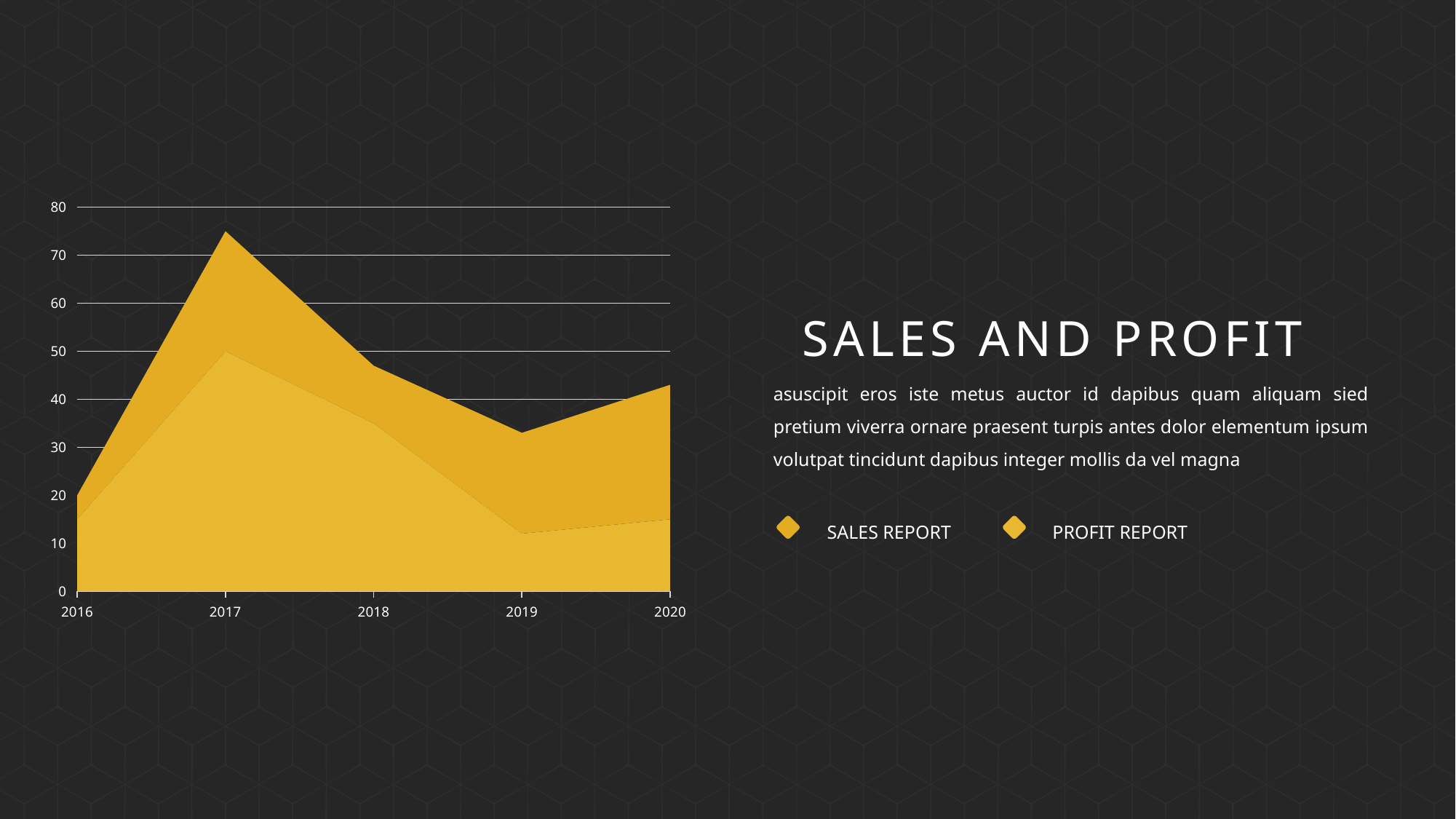
Do the values of the upper (darker) area rise or fall from 2017 to 2019? fall What kind of chart is shown on the slide? Area chart Is the value of the upper (darker) area in 2016 greater or less than 30? less Which year has the larger value for the upper (darker) area, 2017 or 2019? 2017 What are the two legend entries shown on the slide? Sales Report and Profit Report Is the value of the upper (darker) area in 2019 greater or less than 40? less Is the value of the lower (lighter) area in 2019 greater or less than 20? less How many series does the legend list? 2 In which year does the upper (darker) area reach its highest point? 2017 In which year is the upper (darker) area at its lowest point? 2016 How many years are shown on the x axis of the chart? 5